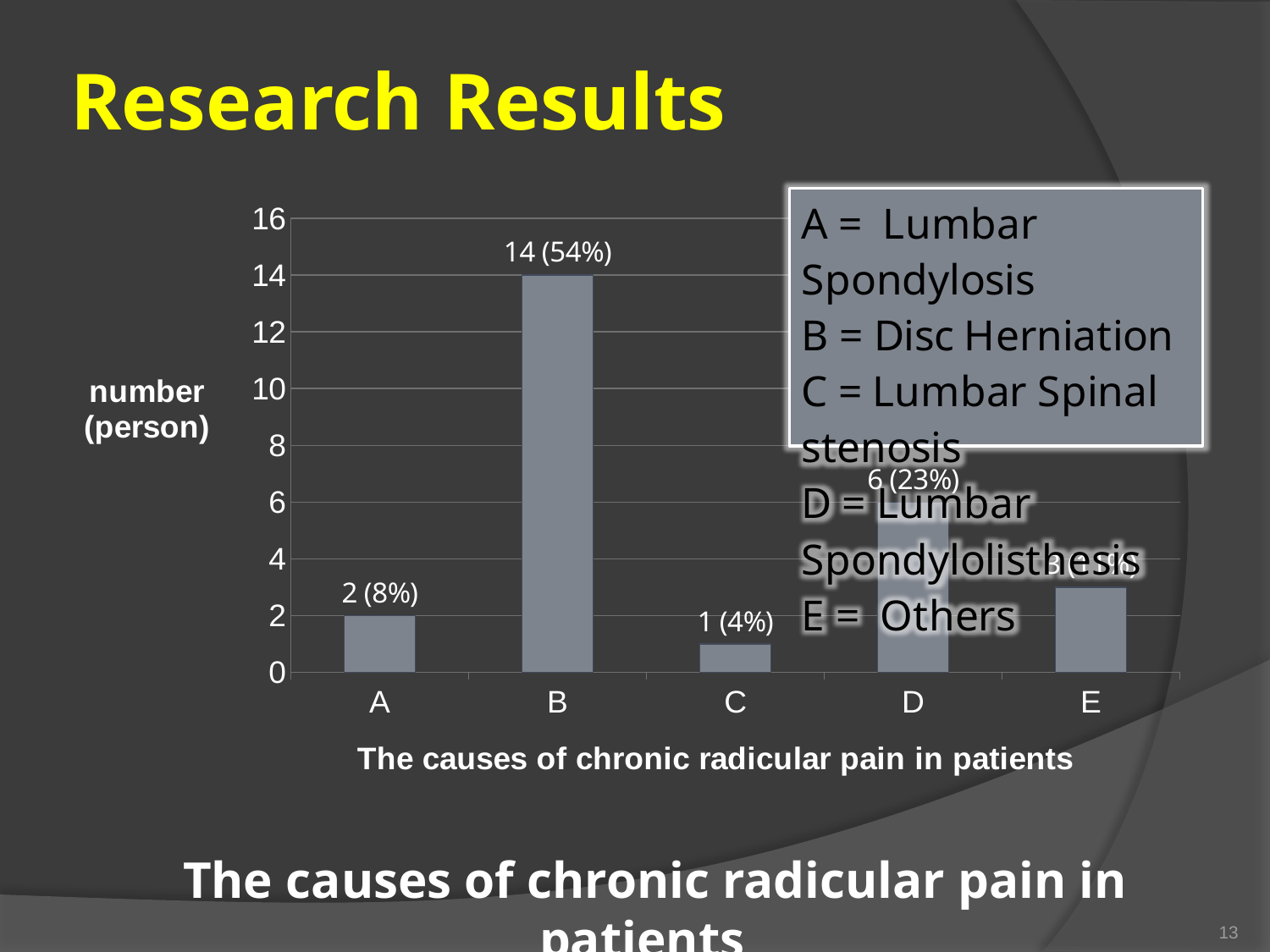
Which category has the lowest value? C What is the value for category D? 6 (23%) Is the value for category E greater or less than 4? less What is the value for category C? 1 (4%) What is the value for category A? 2 (8%) What is the value for category B? 14 (54%) What is the difference in number of persons between category B and category D? 8 Which category has the highest value? B What is the label of the x axis of the chart? The causes of chronic radicular pain in patients How many categories are plotted on the x axis of the chart? 5 What type of chart is shown on the slide? bar chart Which is larger, the value for category A or the value for category D? D